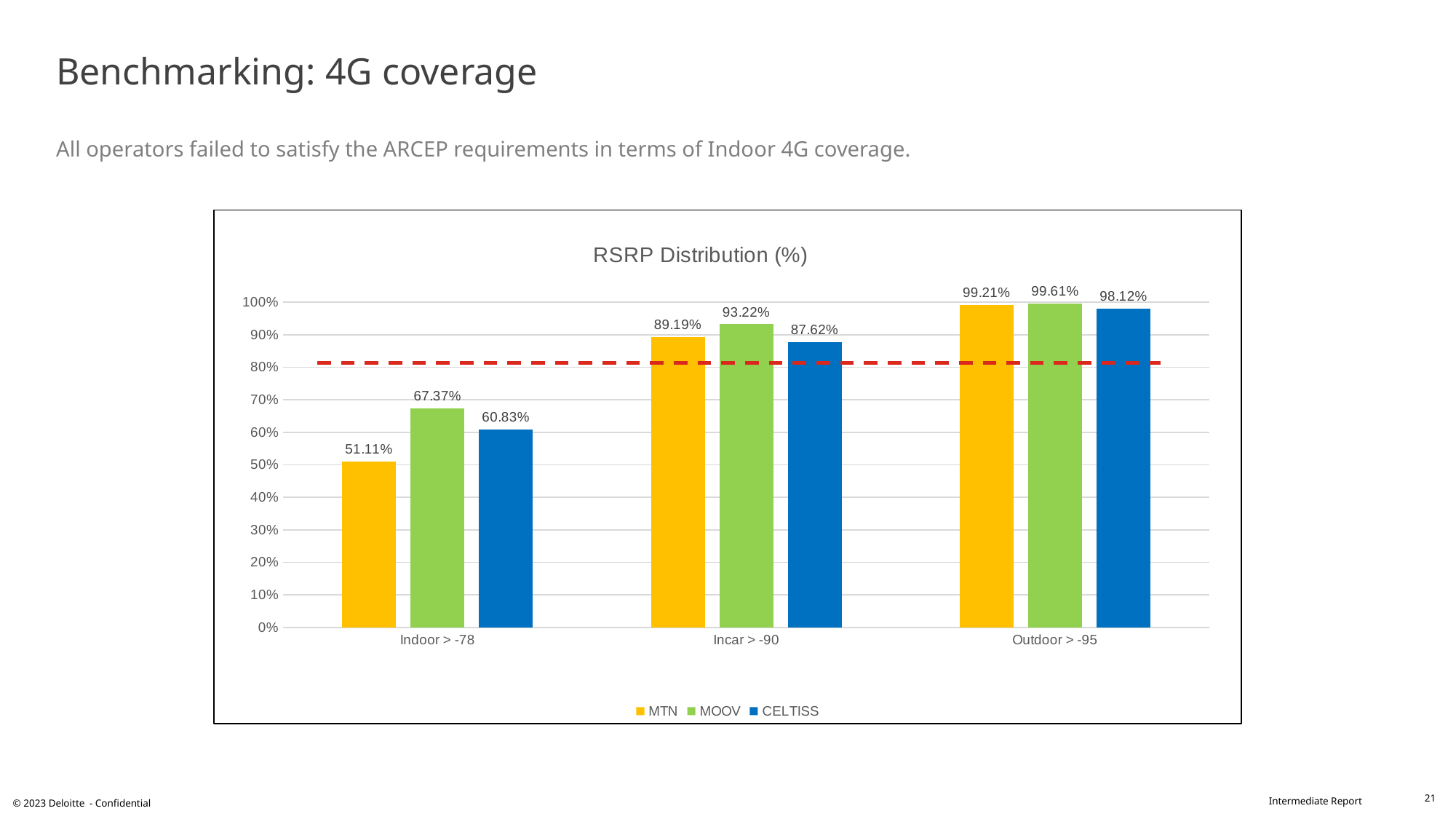
What is the title of the chart? RSRP Distribution (%) How many series does the legend list? 3 Which is larger in the Incar > -90 category: MTN or MOOV? MOOV What is the difference between MOOV and MTN in the Indoor > -78 category? 16.26% What kind of chart is shown on the slide? Bar chart Is the value for CELTISS in the Indoor > -78 category greater or less than 70%? less What is the value for CELTISS in the Incar > -90 category? 87.62% How many categories are shown on the x axis? 3 Which operator has the lowest value in the Outdoor > -95 category? CELTISS What is the value for MTN in the Indoor > -78 category? 51.11% Which operator has the highest value in the Indoor > -78 category? MOOV What is the value for MOOV in the Outdoor > -95 category? 99.61%